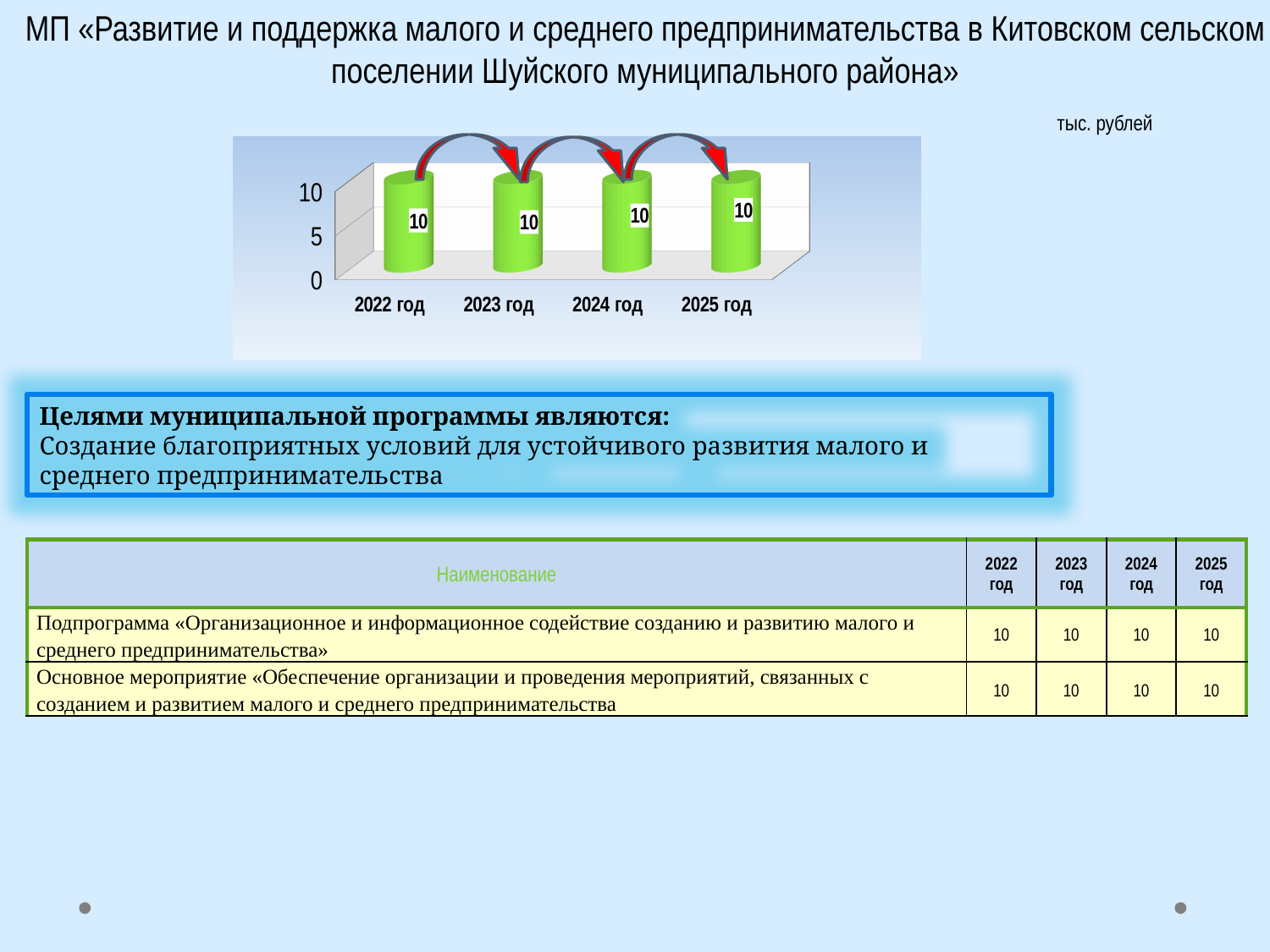
What is the value for 2023 год in the chart? 10 What unit of measurement is indicated for the chart values? тыс. рублей What kind of chart is shown on the slide? bar chart What is the value for 2024 год in the chart? 10 What is the value for 2022 год in the chart? 10 Is the value for 2023 год greater or less than 5? greater What is the highest tick value shown on the vertical axis of the chart? 10 Do the values rise, fall or stay the same from 2022 год to 2025 год? stay the same How many categories (years) are shown on the x axis of the chart? 4 What is the difference between the values for 2025 год and 2022 год? 0 What is the value for 2025 год in the chart? 10 Which is larger, the value for 2022 год or the value for 2024 год? they are equal